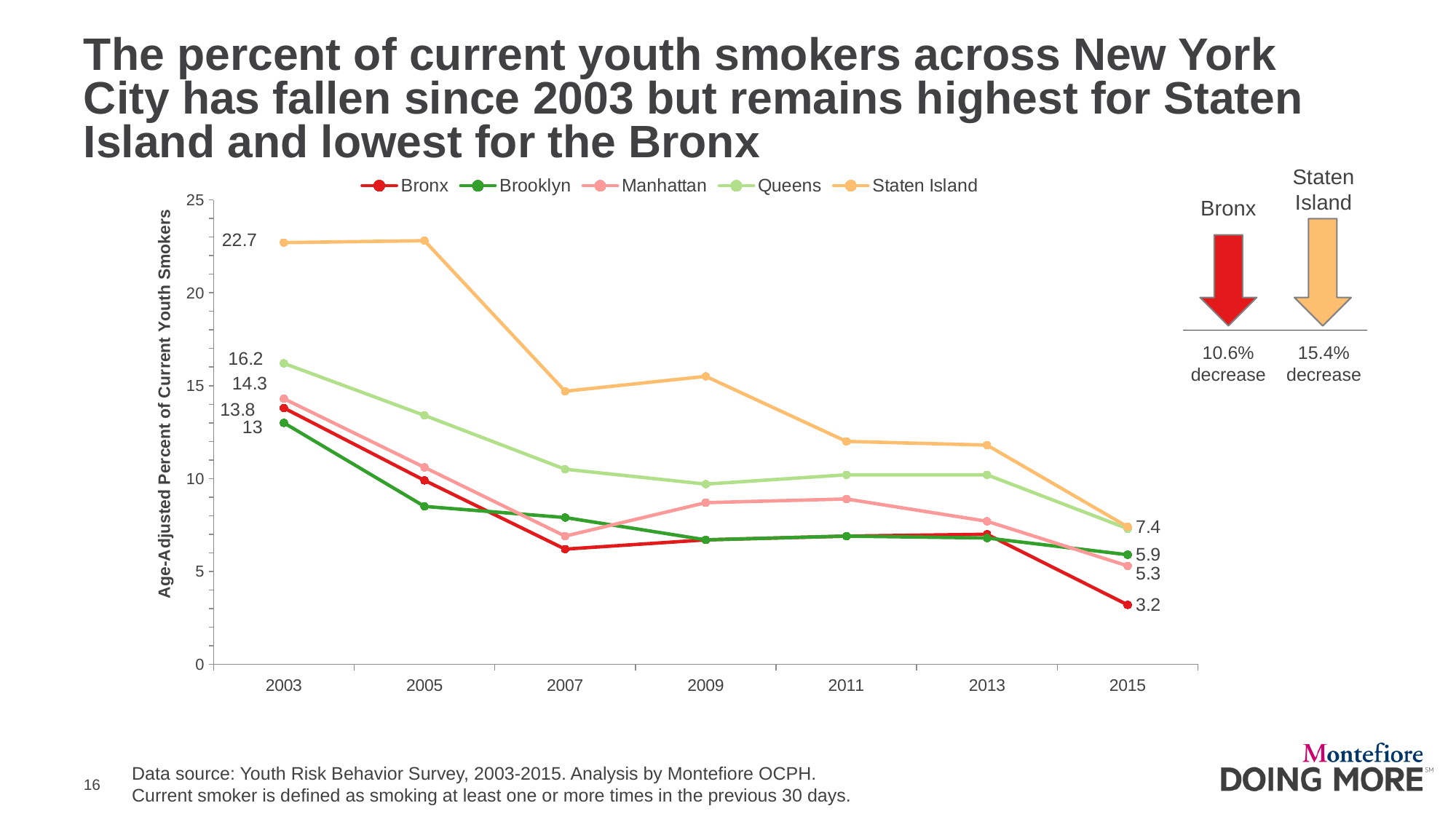
What was the age-adjusted percent of current youth smokers in the Bronx in 2003? 13.8 By how much did the Bronx value fall from 2003 to 2015? 10.6 What was the value for Brooklyn in 2015? 5.9 In 2003, which was higher: Manhattan or Brooklyn? Manhattan How many years are shown on the x axis? 7 What was the value for Manhattan in 2015? 5.3 What was the value for Staten Island in 2003? 22.7 What was the value for the Bronx in 2015? 3.2 Which borough had the lowest percent of current youth smokers in 2015? Bronx Which borough had the highest percent of current youth smokers in 2003? Staten Island Is the value for Staten Island in 2011 greater or less than 10? greater How many series does the legend list? 5